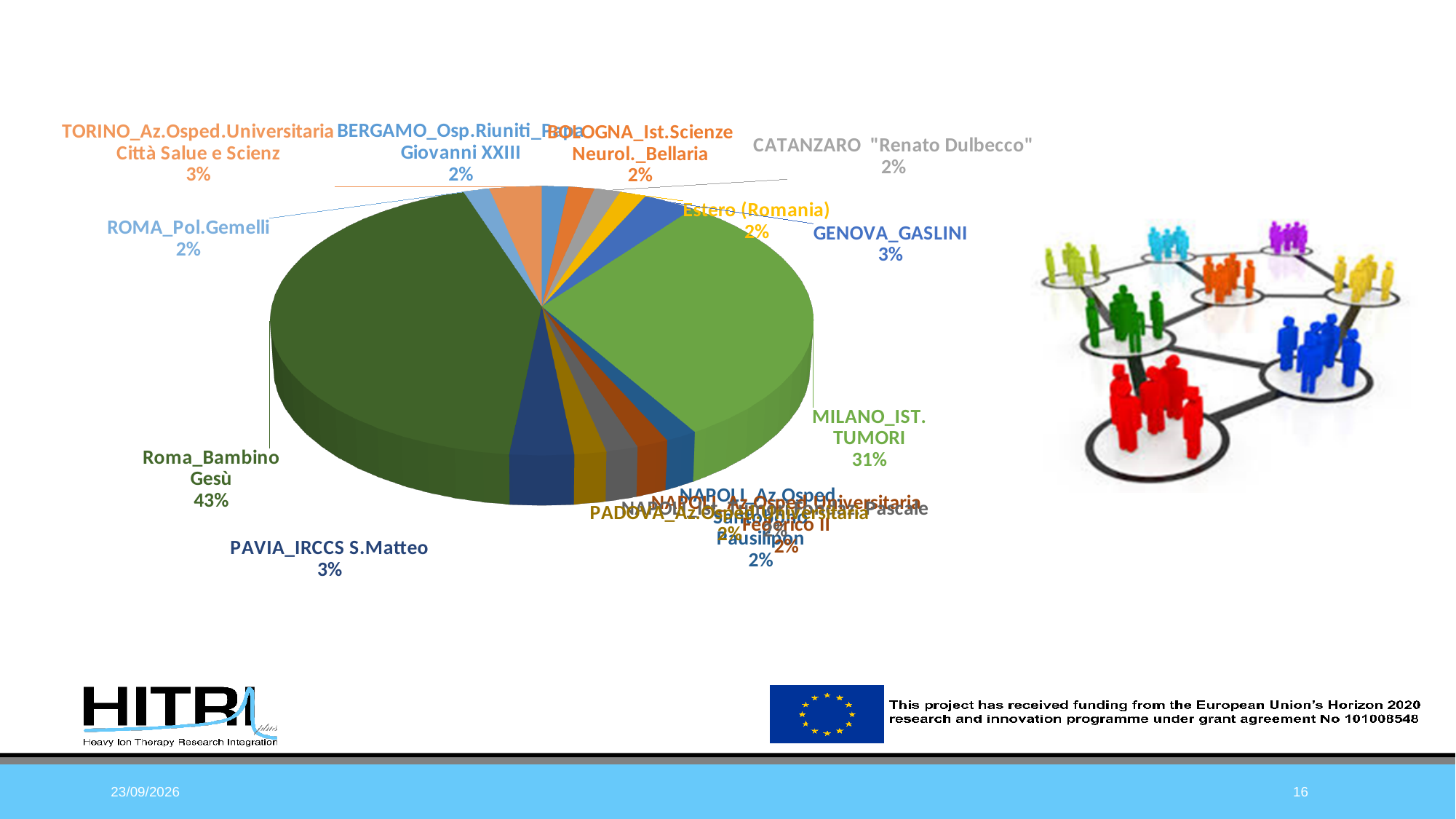
What is the difference between the shares of Roma_Bambino Gesù and MILANO_IST. TUMORI? 12% What share of the pie does Roma_Bambino Gesù hold? 43% Which category has the largest share of the pie? Roma_Bambino Gesù What is the combined share of Roma_Bambino Gesù and MILANO_IST. TUMORI? 74% What is the value shown for CATANZARO "Renato Dulbecco"? 2% What is the value shown for ROMA_Pol.Gemelli? 2% What is the value shown for GENOVA_GASLINI? 3% What kind of chart is shown on the slide? pie chart What share of the pie does MILANO_IST. TUMORI hold? 31% What is the value shown for Estero (Romania)? 2% Which is larger, the share for MILANO_IST. TUMORI or the share for GENOVA_GASLINI? MILANO_IST. TUMORI What is the value shown for PAVIA_IRCCS S.Matteo? 3%